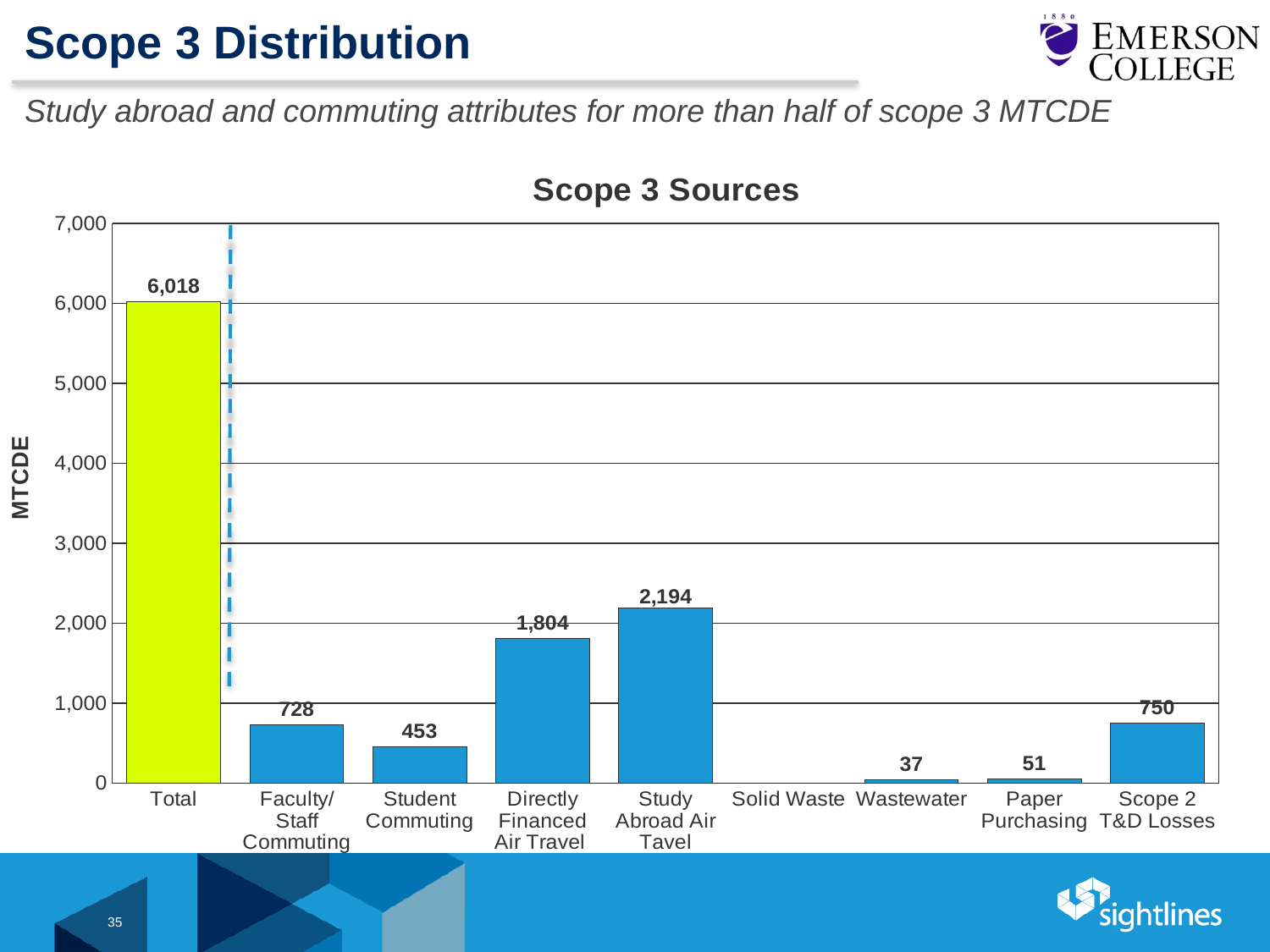
Excluding the Total bar, which source has the highest value? Study Abroad Air Tavel What is the difference between Study Abroad Air Tavel and Directly Financed Air Travel? 390 What is the value for Scope 2 T&D Losses? 750 How many categories are shown on the x axis of the Scope 3 Sources chart? 9 What is the value for Wastewater? 37 What is the difference between Faculty/Staff Commuting and Student Commuting? 275 What is the value of the Total bar in the Scope 3 Sources chart? 6,018 What is the value shown for Directly Financed Air Travel? 1,804 What is the label on the y axis of the chart? MTCDE Is the value for Directly Financed Air Travel greater or less than 1,000? greater Which is larger, Scope 2 T&D Losses or Faculty/Staff Commuting? Scope 2 T&D Losses What is the MTCDE value for Study Abroad Air Tavel? 2,194